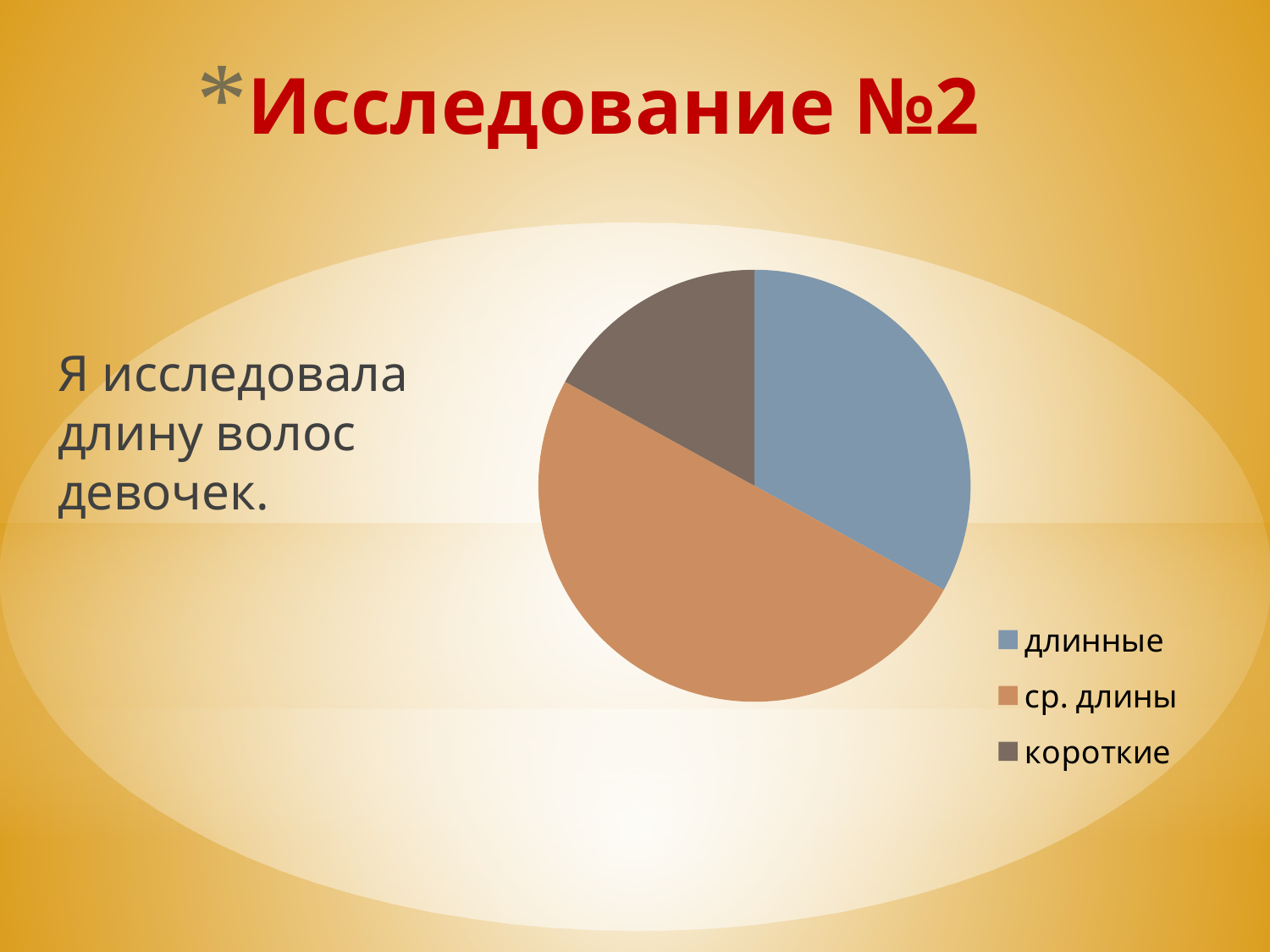
How many entries does the legend of the pie chart list? 3 Which slice is larger in the pie chart: ср. длины or длинные? ср. длины How many slices does the pie chart have? 3 Which category is shown in grey in the pie chart? короткие Which slice is larger in the pie chart: длинные or короткие? длинные Which slice is larger in the pie chart: ср. длины or короткие? ср. длины What kind of chart is shown on the slide? pie chart Which category has the smallest slice of the pie chart? короткие What colour is the slice for длинные in the pie chart? blue Which category has the largest slice of the pie chart? ср. длины